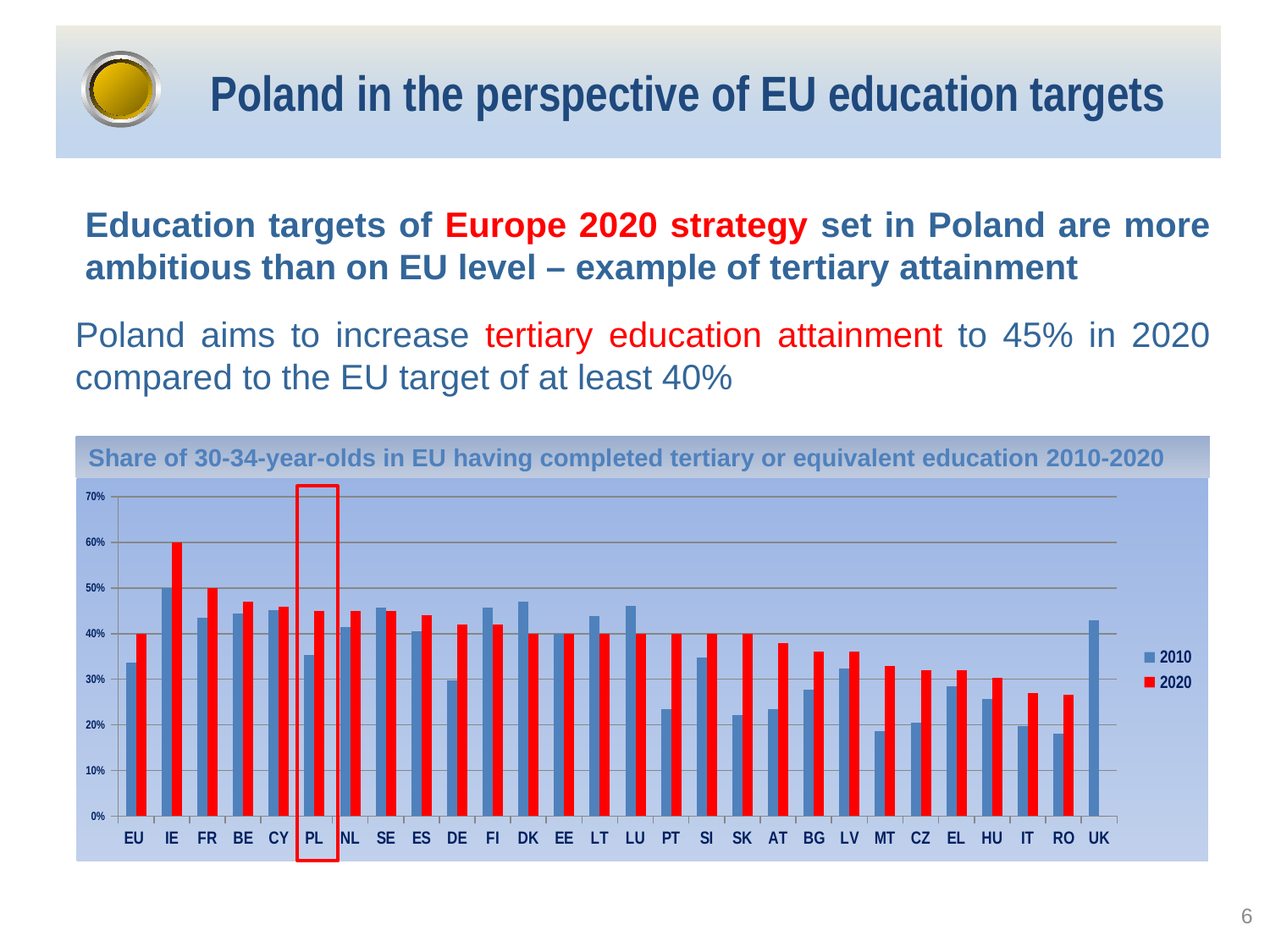
What are the two series named in the chart legend? 2010 and 2020 What is the 2020 value for IE? 60% What is the 2020 value for EU? 40% How many categories are shown on the x axis of the chart? 28 Which category on the x axis is highlighted with a red box? PL Is the 2010 value for PL greater or less than 40%? less How many series does the legend of the chart list? 2 Is the 2010 value for UK greater or less than 40%? greater Which is larger: the 2020 value for IE or the 2020 value for FR? IE What kind of chart is shown on the slide? bar chart Which country has the highest 2020 value in the chart? IE Is the 2010 value for MT greater or less than 20%? less